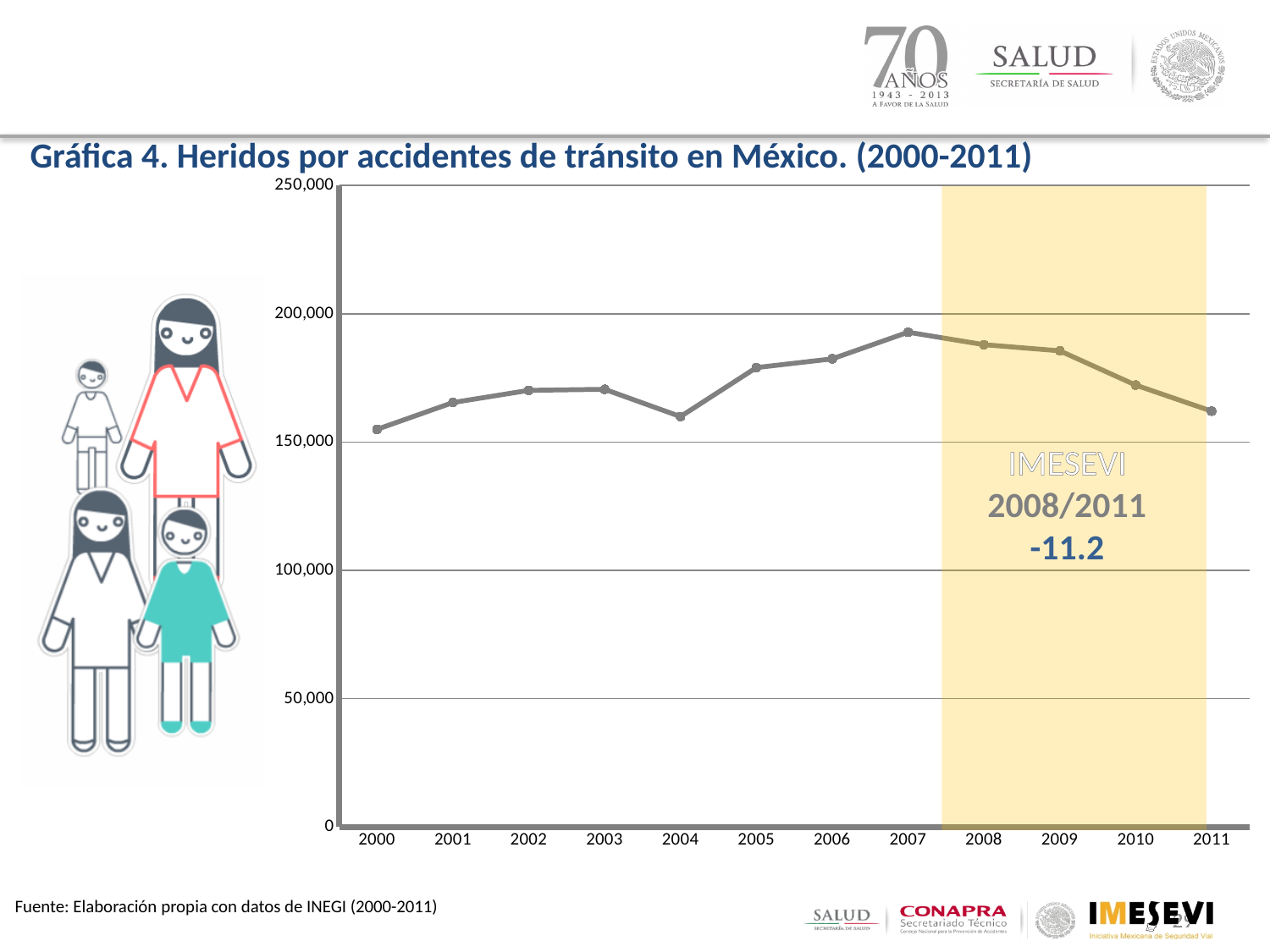
What percentage change is printed in the highlighted 2008/2011 region of the chart? -11.2 Which year has a higher value, 2002 or 2004? 2002 Which year has a higher value, 2007 or 2011? 2007 In which year is the number of injured highest? 2007 Is the value for 2004 greater or less than 200,000? less Is the value for 2007 greater or less than 150,000? greater Do the values rise or fall from 2007 to 2011? fall In which year is the number of injured lowest? 2000 What kind of chart is shown on the slide? line chart How many years (data points) are plotted on the chart? 12 Is the value for 2000 greater or less than 200,000? less